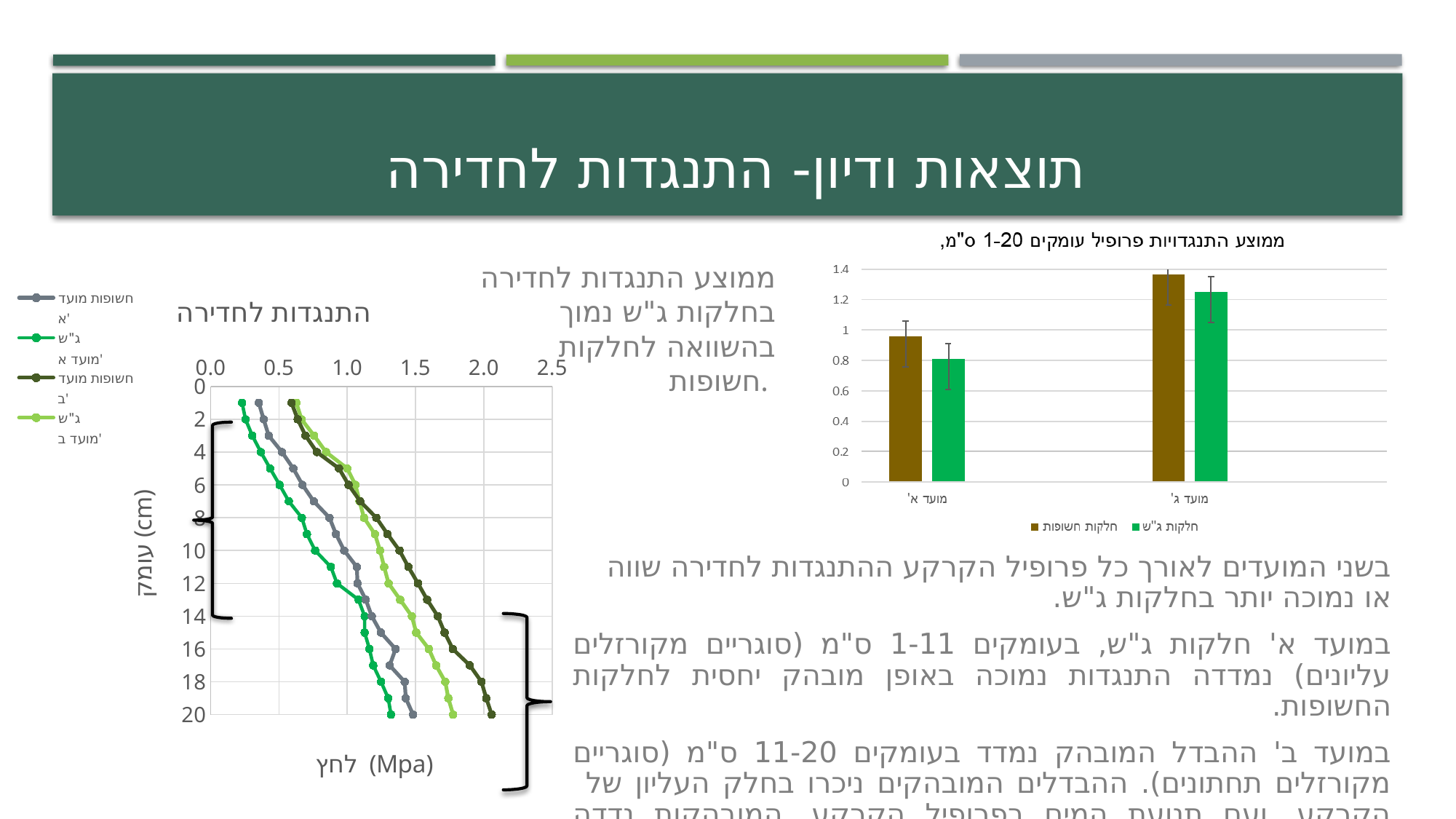
In the left-hand line chart, is the value for ג"ש מועד ב' at depth 20 greater or less than 1.5? greater How many series does the legend of the right-hand bar chart list? 2 In the right-hand bar chart, is the value for חלקות ג"ש at מועד א' greater or less than 1? less How many categories are shown on the x axis of the right-hand bar chart? 2 In the left-hand line chart, does the pressure (לחץ) generally increase or decrease as depth increases from 0 to 20 cm? increase In the right-hand bar chart, which bar is the tallest? חלקות חשופות at מועד ג' What kind of chart is the chart on the right of the slide (ממוצע התנגדויות פרופיל עומקים 1-20 ס"מ)? bar chart What kind of chart is the chart on the left of the slide (התנגדות לחדירה)? line chart How many series does the legend of the left-hand line chart list? 4 In the right-hand bar chart, at מועד א', which series has the taller bar: חלקות חשופות or חלקות ג"ש? חלקות חשופות In the right-hand bar chart, is the חלקות חשופות bar taller at מועד א' or at מועד ג'? מועד ג' In the right-hand bar chart, is the value for חלקות חשופות at מועד ג' greater or less than 1.2? greater